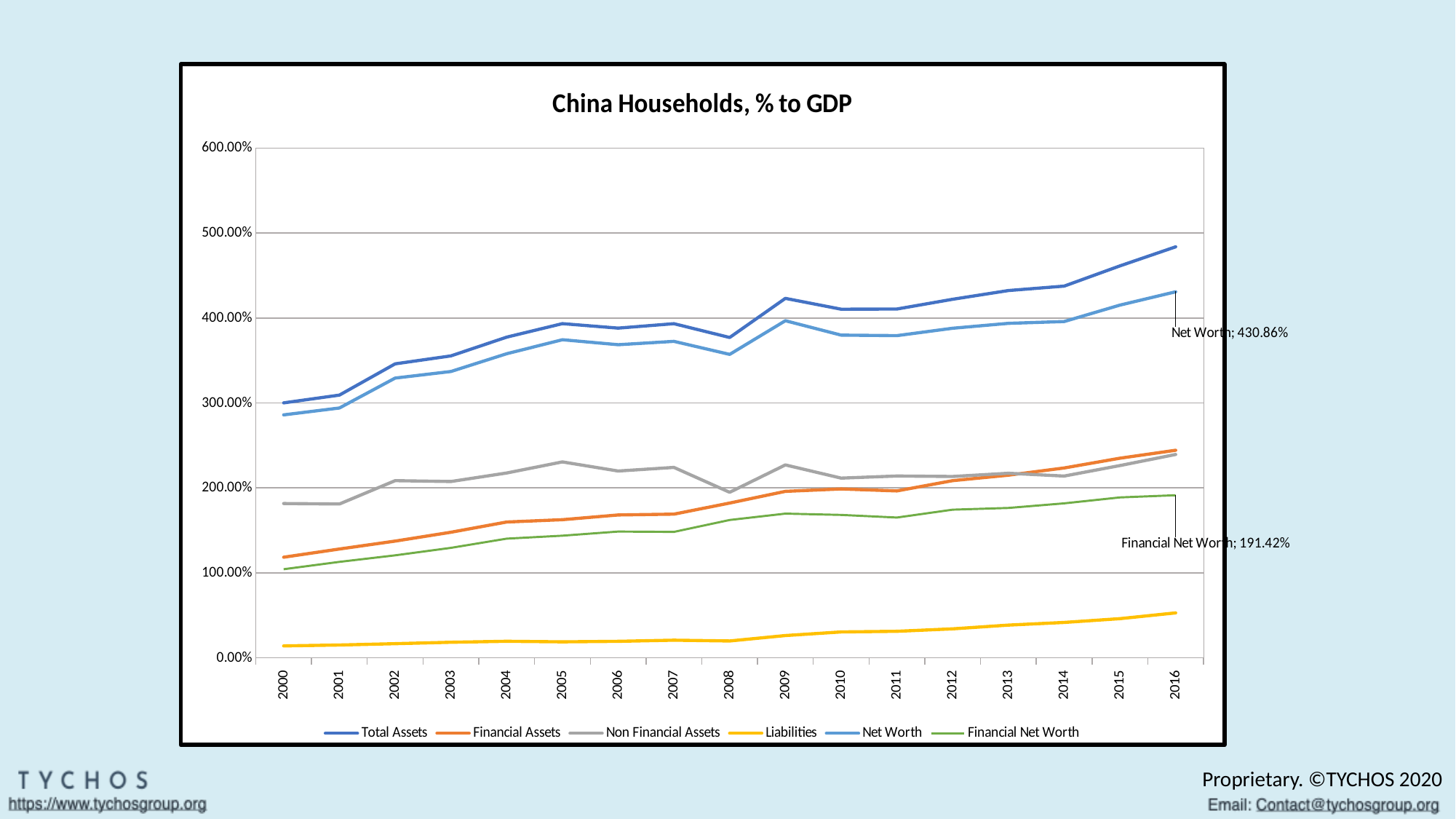
How many years are shown on the x axis? 17 Which series has the highest value in 2016? Total Assets What kind of chart is shown on the slide? line chart Which series has the lowest values across the chart? Liabilities What is the value of Financial Net Worth in 2016? 191.42% What is the difference between Net Worth and Financial Net Worth in 2016? 239.44% Is the value for Total Assets in 2016 greater or less than 500.00%? less Is the value for Liabilities in 2016 greater or less than 100.00%? less Does the Total Assets series generally rise or fall from 2000 to 2016? rise How many series does the legend list? 6 What is the title of the chart? China Households, % to GDP What is the value of Net Worth in 2016? 430.86%